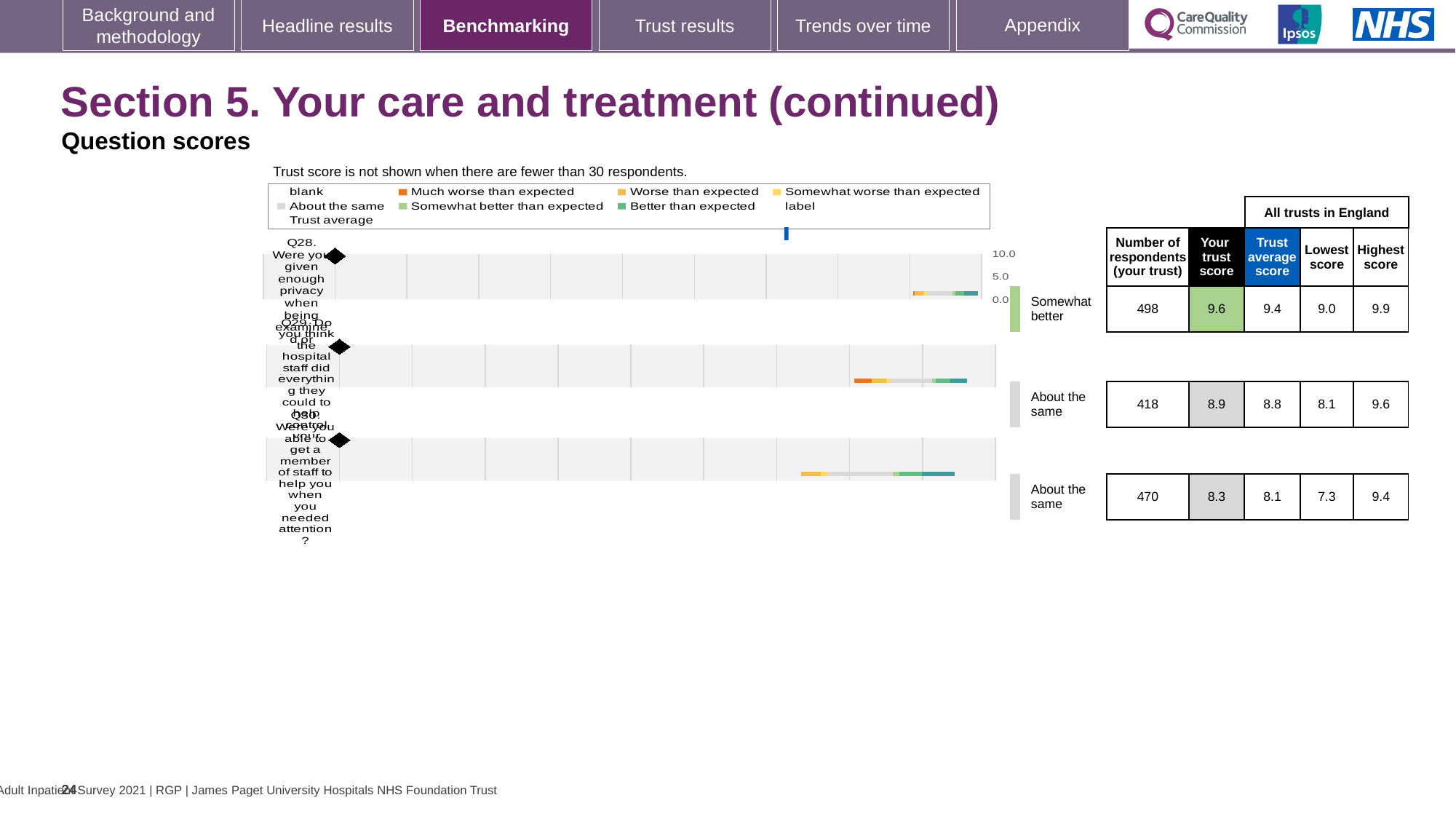
Which question has the lowest 'Your trust score'? Q30 What is the difference between the trust score and the trust average score for Q29? 0.1 What kind of chart is used to show the question scores? Bar chart What is the trust score for Q28 shown in the 'Your trust score' column? 9.6 What benchmark category is shown next to Q28's bar? Somewhat better What is the trust average score for Q30? 8.1 What is the highest score across all trusts in England for Q28? 9.9 What is the number of respondents for Q29? 418 Which is larger for Q30: the trust score or the trust average score? Trust score How many questions are plotted on the chart? 3 What is the lowest score across all trusts in England for Q30? 7.3 Which question has the highest 'Your trust score'? Q28